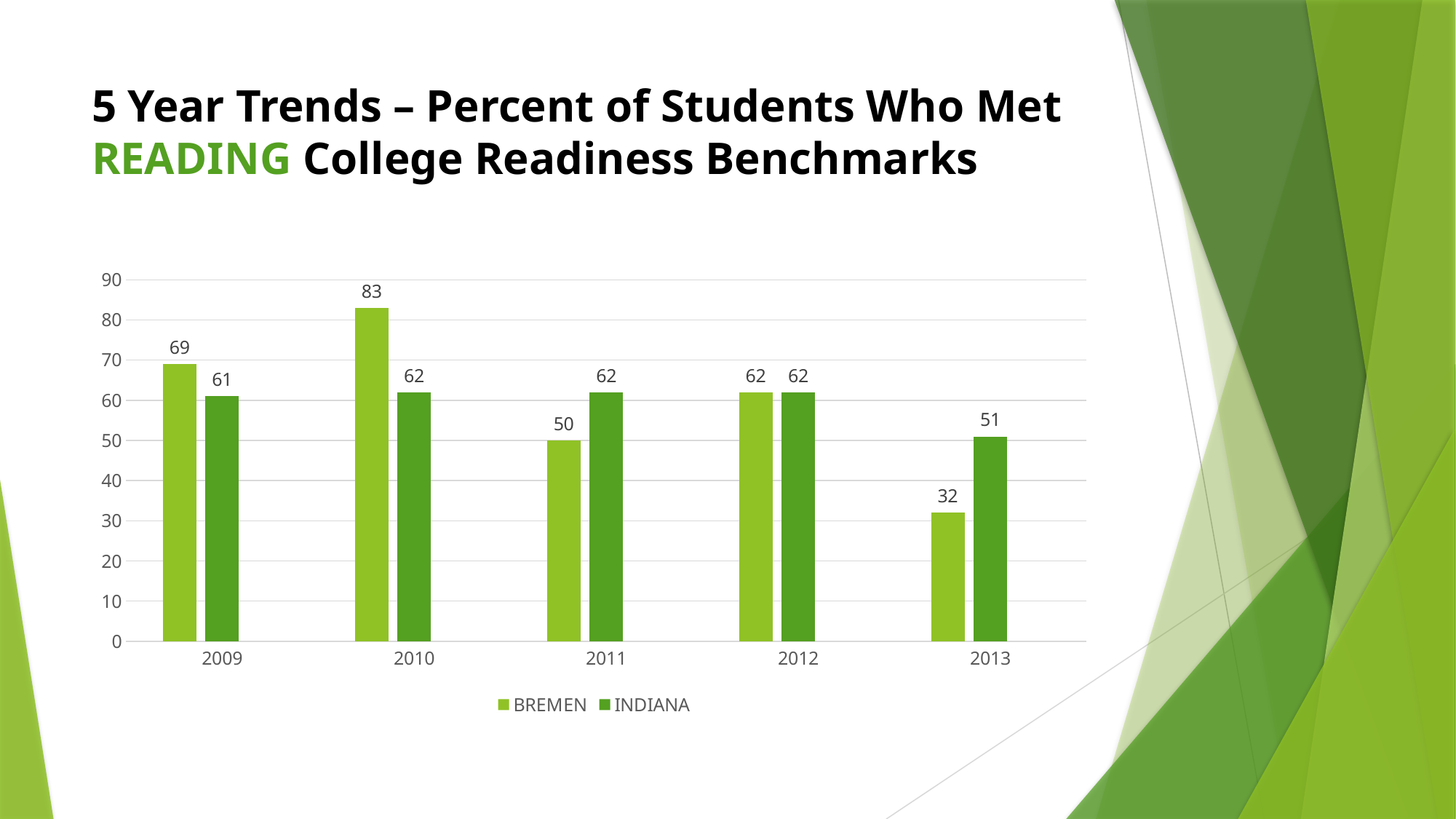
What kind of chart is shown on the slide? bar chart What is the INDIANA value for 2013? 51 What is the difference between the BREMEN and INDIANA values in 2010? 21 How many series does the legend list? 2 Is the BREMEN value for 2009 greater or less than 60? greater In which year is the BREMEN value lowest? 2013 What is the BREMEN value for 2013? 32 How many years are shown on the x axis? 5 In which year is the BREMEN value highest? 2010 Which is larger in 2011, the BREMEN value or the INDIANA value? INDIANA Which series is shown in the darker green colour? INDIANA What is the BREMEN value for 2010? 83